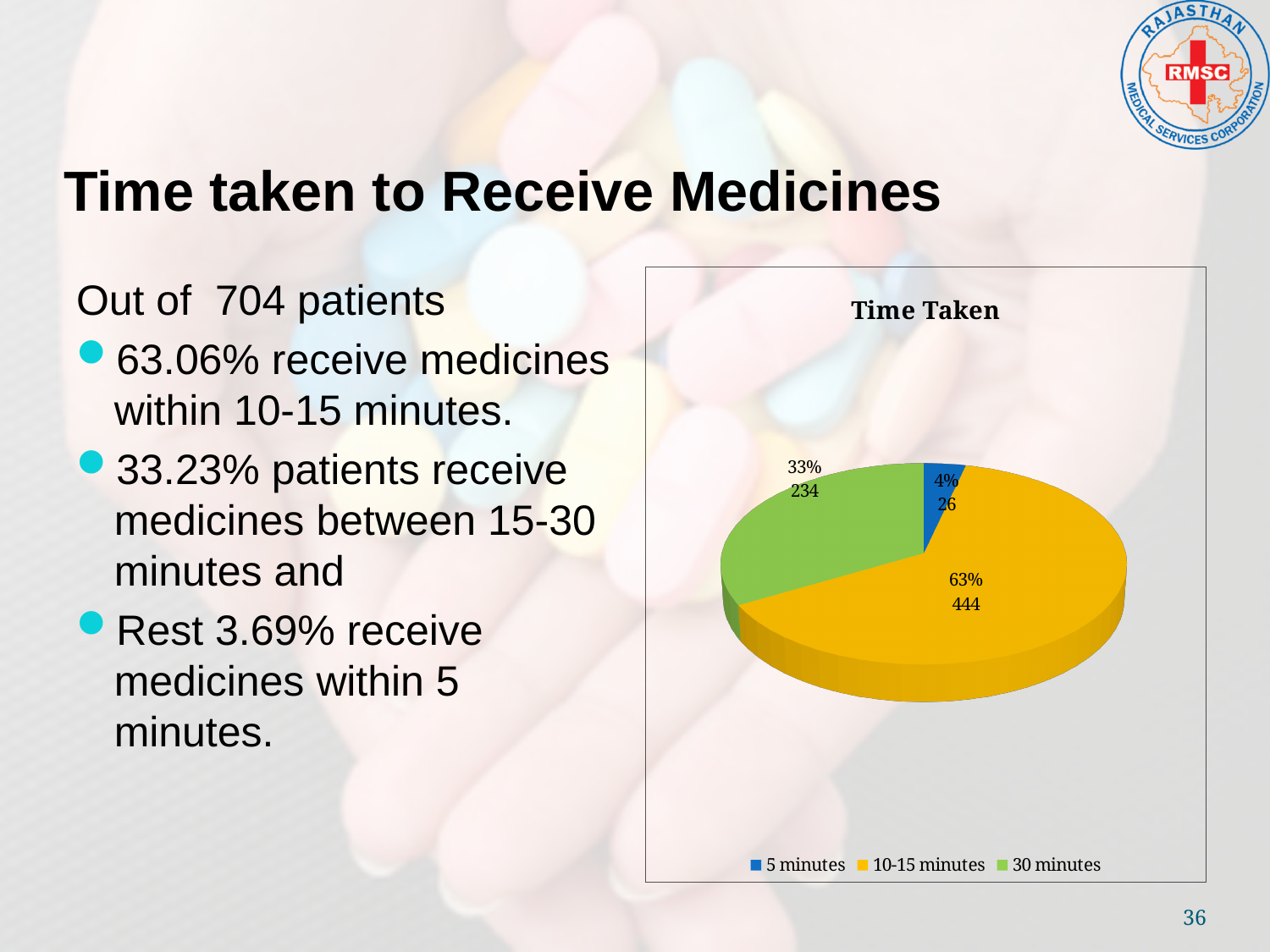
What share of the pie does the 10-15 minutes slice represent? 63% What is the value shown for the 5 minutes slice? 26 How many slices does the pie chart have? 3 What share of the pie does the 30 minutes slice represent? 33% How many entries does the chart legend list? 3 What is the value shown for the 10-15 minutes slice? 444 What kind of chart is shown on the slide? pie chart Which category has the largest slice of the pie? 10-15 minutes Which category has the smallest slice of the pie? 5 minutes What is the difference between the values for 10-15 minutes and 30 minutes? 210 What is the title of the chart? Time Taken What share of the pie does the 5 minutes slice represent? 4%